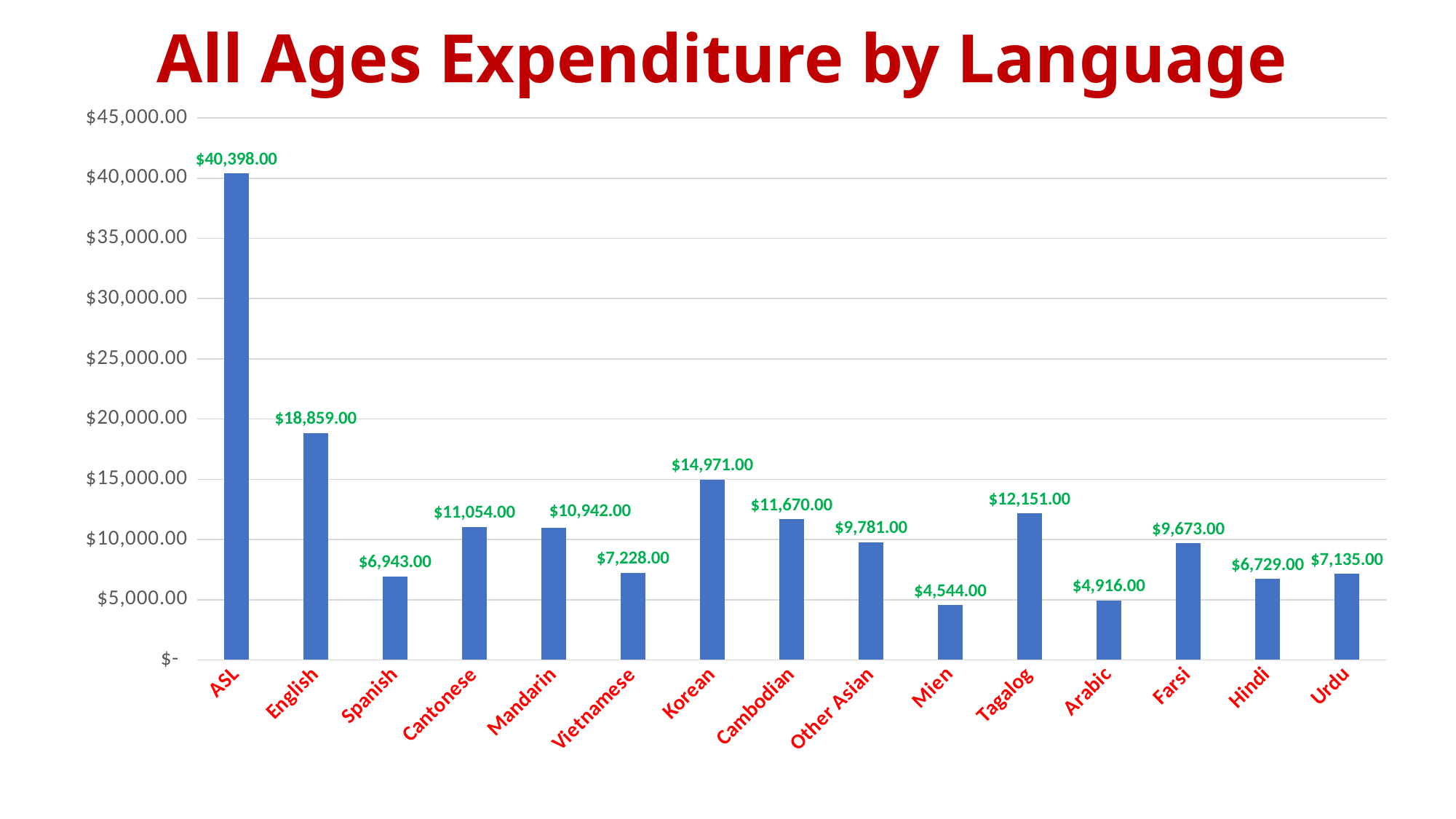
Which language has the lowest expenditure? Mien What is the difference between the expenditure for Cantonese and Mandarin? $112.00 Which language has the highest expenditure? ASL How many languages are shown on the chart? 15 What is the expenditure for ASL? $40,398.00 What kind of chart is shown on the slide? bar chart Which has a larger expenditure, Korean or Cambodian? Korean What is the difference between the expenditure for ASL and English? $21,539.00 What is the expenditure for Tagalog? $12,151.00 What is the expenditure for Korean? $14,971.00 What is the title of the chart? All Ages Expenditure by Language Is the expenditure for Farsi greater or less than $10,000.00? less